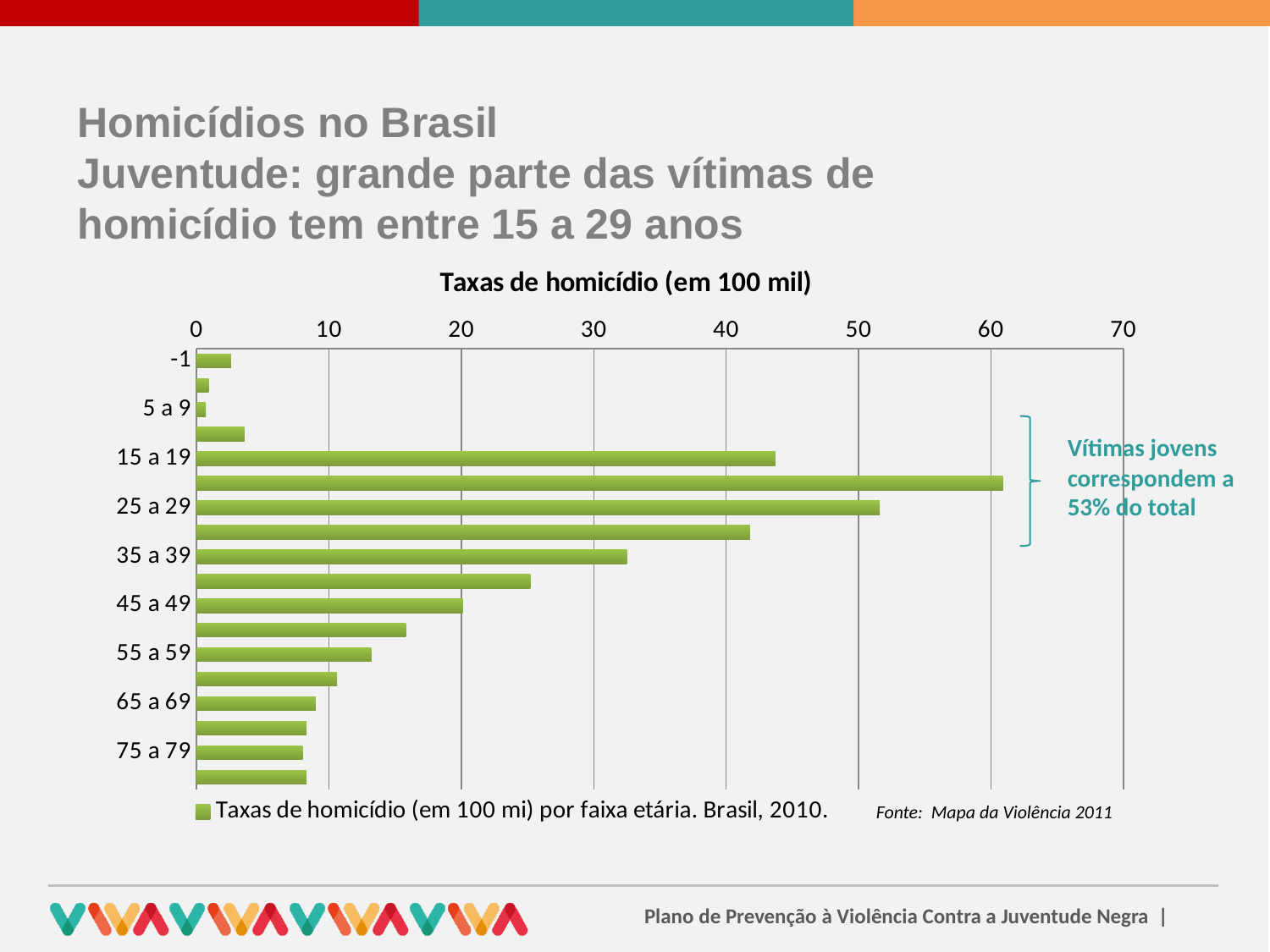
What kind of chart is shown on the slide? bar chart What is the title of the chart? Taxas de homicídio (em 100 mil) Which has the larger value, 15 a 19 or 25 a 29? 25 a 29 Is the value for 15 a 19 greater or less than 40? greater How many series does the chart legend list? 1 Is the value for 65 a 69 greater or less than 10? less Is the value for 35 a 39 greater or less than 30? greater According to the annotation on the chart, what share of the total do young victims represent? 53% How many bars are plotted in the chart? 18 From the 25 a 29 age group to the 75 a 79 age group, do the values rise or fall? fall Which has the larger value, 35 a 39 or 55 a 59? 35 a 39